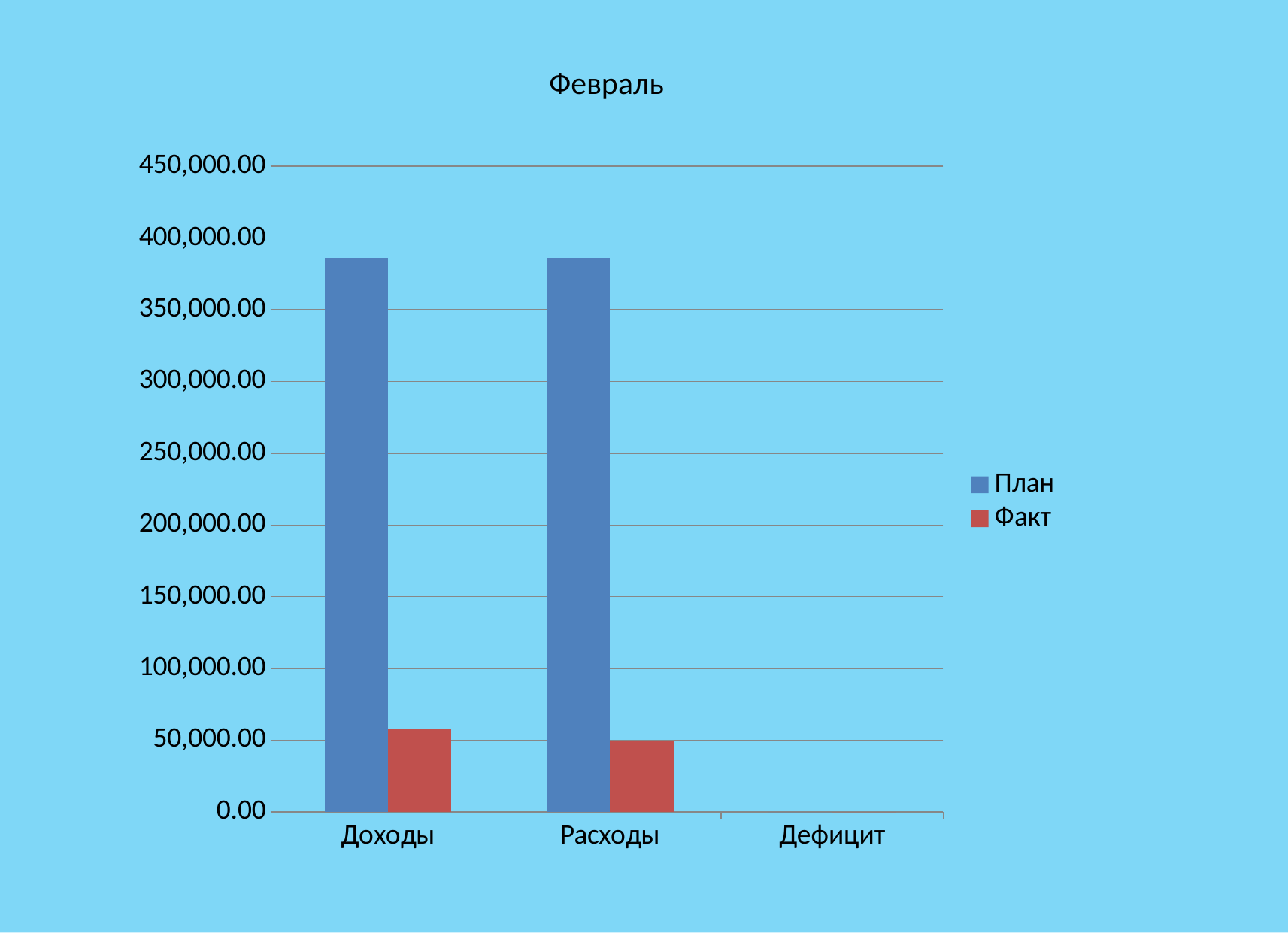
How many series does the legend list? 2 Which category has the lowest Факт value? Дефицит Which series is shown in blue? План Is the Факт value for Доходы greater or less than 100,000.00? less How many categories are shown on the x axis? 3 Is the План value for Расходы greater or less than 400,000.00? less Which category has the highest Факт value? Доходы Is the План value for Доходы greater or less than 350,000.00? greater What is the title of the chart? Февраль For Доходы, which is larger: План or Факт? План What kind of chart is shown on the slide? bar chart